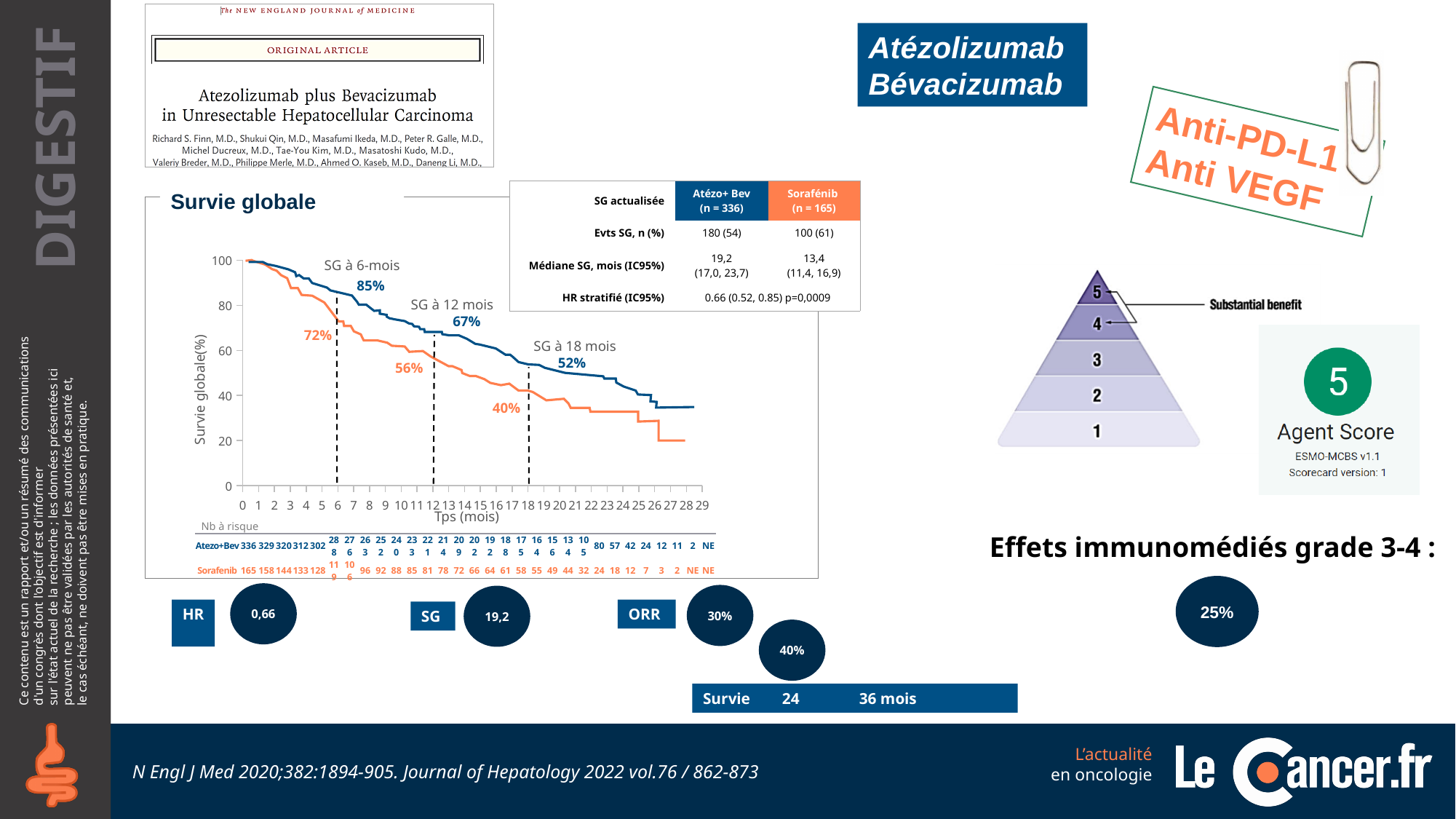
What kind of chart is the 'Survie globale' chart? Kaplan-Meier survival curve (line chart) In the 'Survie globale' chart, what is the overall survival at 12 months for the Sorafenib arm? 56% In the 'Survie globale' chart, which arm has the higher overall survival at 12 months, Atezo+Bev or Sorafenib? Atezo+Bev In the 'Survie globale' chart, what is the overall survival at 18 months for the Atezo+Bev arm? 52% In the 'Survie globale' chart, what is the overall survival at 6 months for the Atezo+Bev arm? 85% In the 'Survie globale' chart, what is the overall survival at 6 months for the Sorafenib arm? 72% In the 'Survie globale' chart, what is the label of the y axis? Survie globale(%) In the 'Survie globale' chart, what is the overall survival at 12 months for the Atezo+Bev arm? 67% In the 'Survie globale' chart, what is the difference in overall survival at 18 months between the Atezo+Bev and Sorafenib arms? 12% In the 'Survie globale' chart, do the survival curves rise or fall as time (Tps, mois) increases? fall In the 'Survie globale' chart, what is the overall survival at 18 months for the Sorafenib arm? 40% In the 'Survie globale' chart, what is the difference in overall survival at 6 months between the Atezo+Bev and Sorafenib arms? 13%